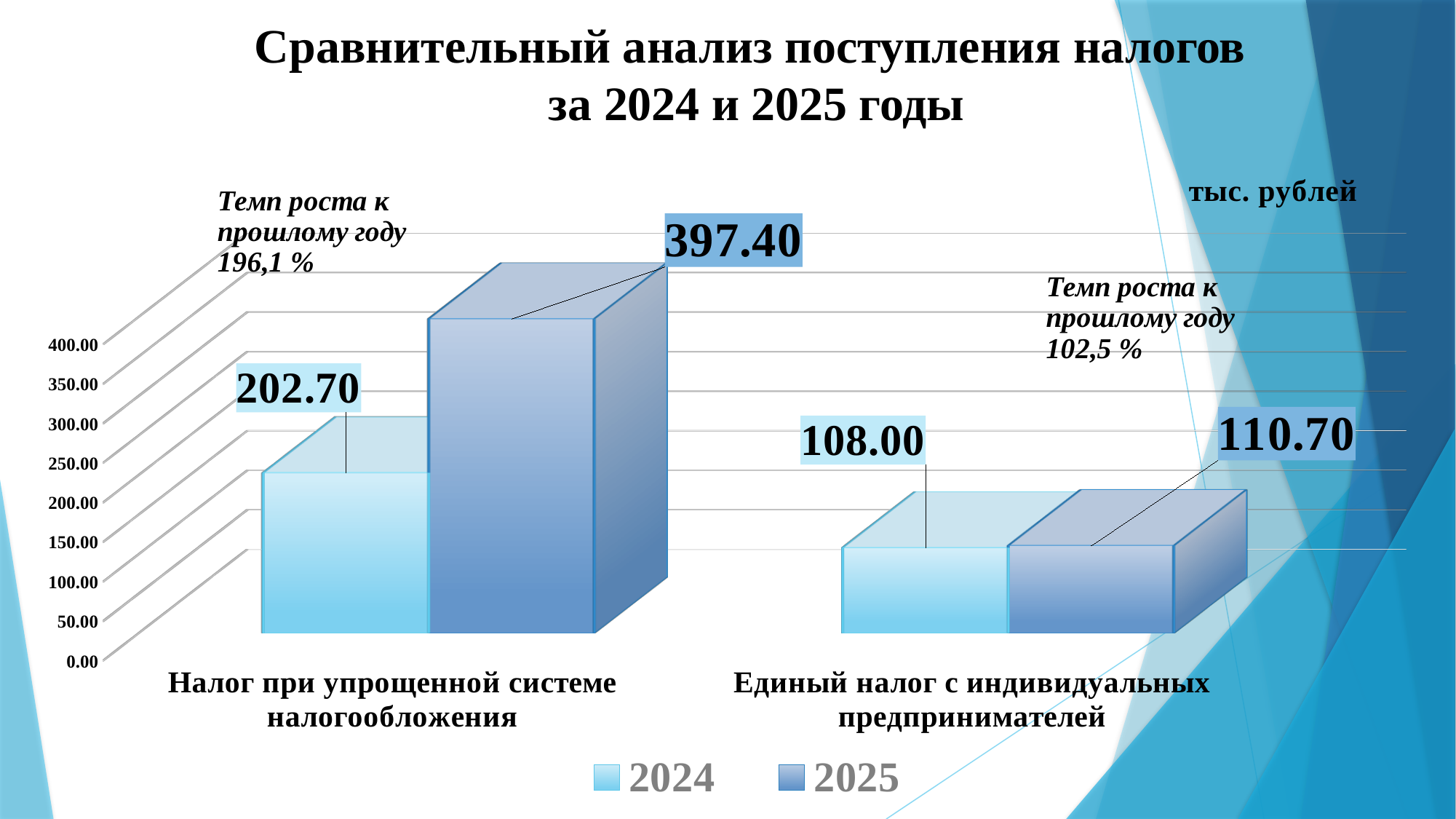
What is the 2024 value for "Налог при упрощенной системе налогообложения"? 202.70 For "Единый налог с индивидуальных предпринимателей", which year has the larger value, 2024 or 2025? 2025 What is the 2024 value for "Единый налог с индивидуальных предпринимателей"? 108.00 Which bar has the highest value on the chart? 2025, Налог при упрощенной системе налогообложения What is the difference between the 2025 and 2024 values for "Налог при упрощенной системе налогообложения"? 194.70 What unit of measurement is indicated on the chart? тыс. рублей What kind of chart is shown on the slide? Bar chart What is the 2025 value for "Налог при упрощенной системе налогообложения"? 397.40 What is the 2025 value for "Единый налог с индивидуальных предпринимателей"? 110.70 Which bar has the lowest value on the chart? 2024, Единый налог с индивидуальных предпринимателей How many series does the legend list? 2 What is the difference between the 2025 and 2024 values for "Единый налог с индивидуальных предпринимателей"? 2.70